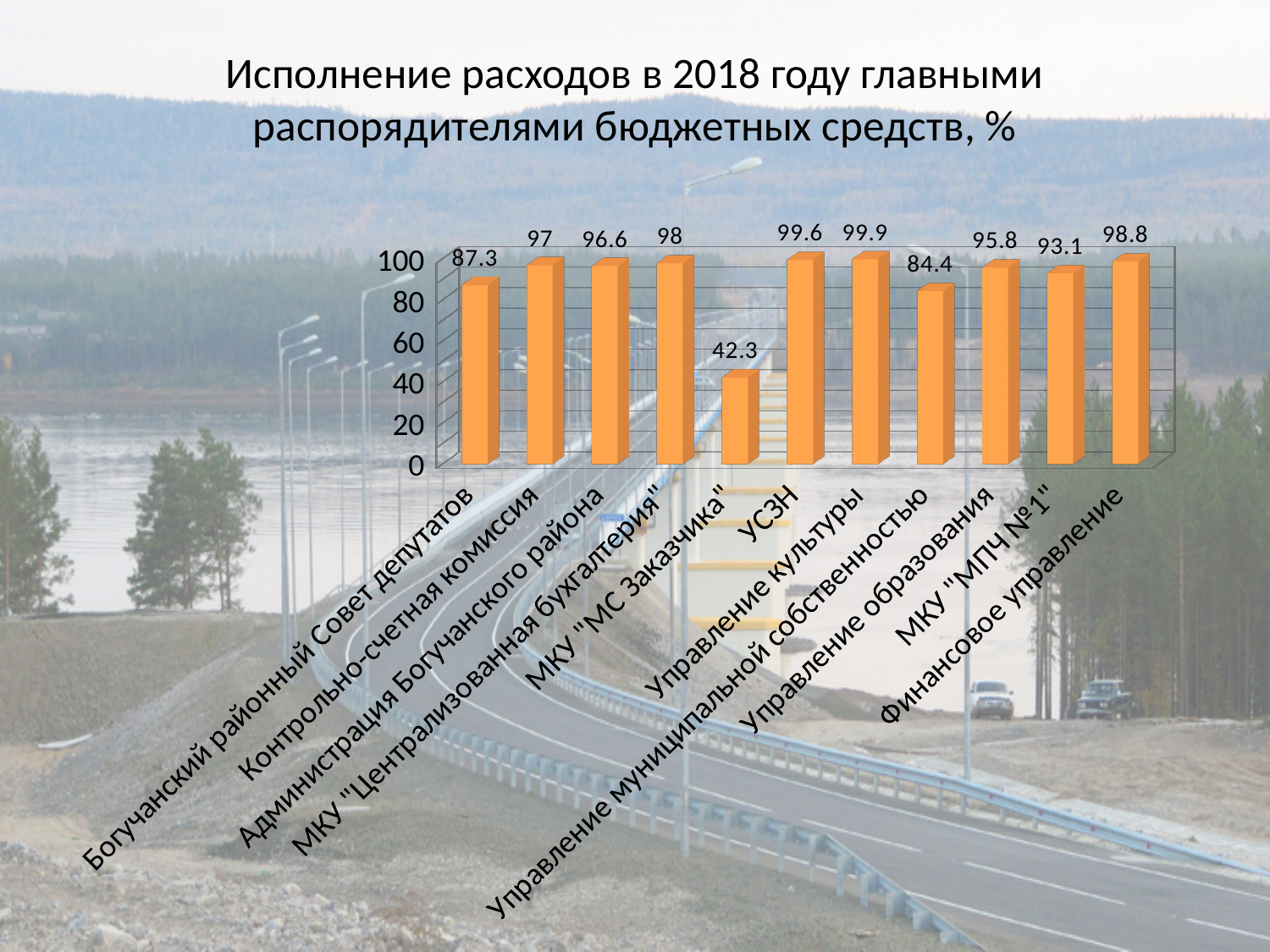
What is the title of the chart? Исполнение расходов в 2018 году главными распорядителями бюджетных средств, % What is the value for МКУ "МС Заказчика"? 42.3 Which category has the lowest value? МКУ "МС Заказчика" What kind of chart is shown on the slide? bar chart What is the value for Финансовое управление? 98.8 What is the value for Управление муниципальной собственностью? 84.4 Which is larger: the value for Управление образования or the value for МКУ "МПЧ №1"? Управление образования Is the value for Управление муниципальной собственностью greater or less than 80? greater Which category has the highest value? Управление культуры What is the difference between the values for Контрольно-счетная комиссия and Богучанский районный Совет депутатов? 9.7 What is the value for УСЗН? 99.6 How many categories are shown in the chart? 11